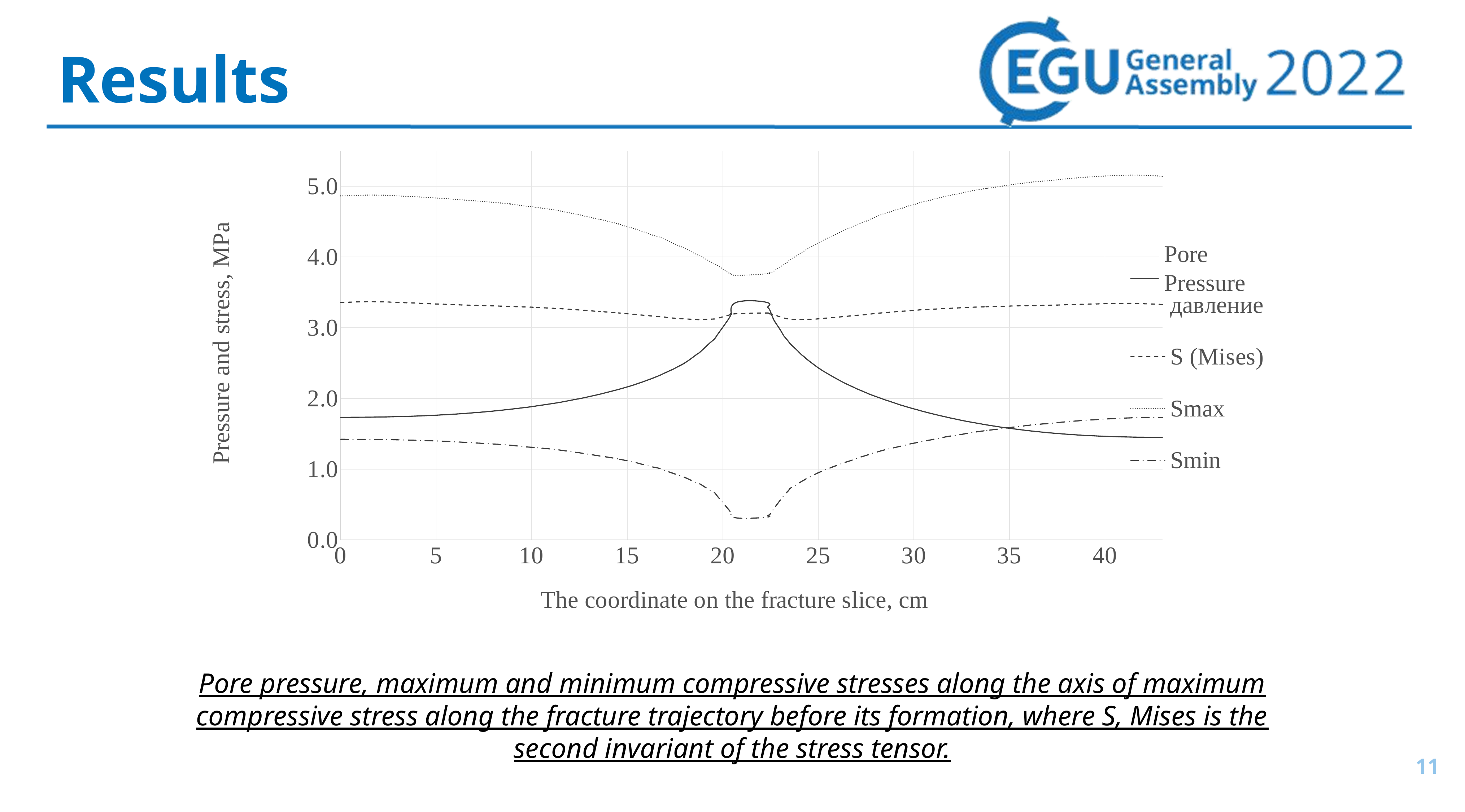
What is the label of the y axis of the chart? Pressure and stress, MPa How many series does the legend of the chart list? 4 Does Smax rise or fall as the coordinate increases from 0 cm to 20 cm? fall Which series has the highest values across the whole chart? Smax Is the lowest value of Smin, near coordinate 21 cm, greater or less than 1.0? less Is the peak value of Pore Pressure, near coordinate 21 cm, greater or less than 3.0? greater Is the value of Pore Pressure at coordinate 0 cm greater or less than 2.0? less What is the label of the x axis of the chart? The coordinate on the fracture slice, cm What kind of chart is shown on the slide? line chart